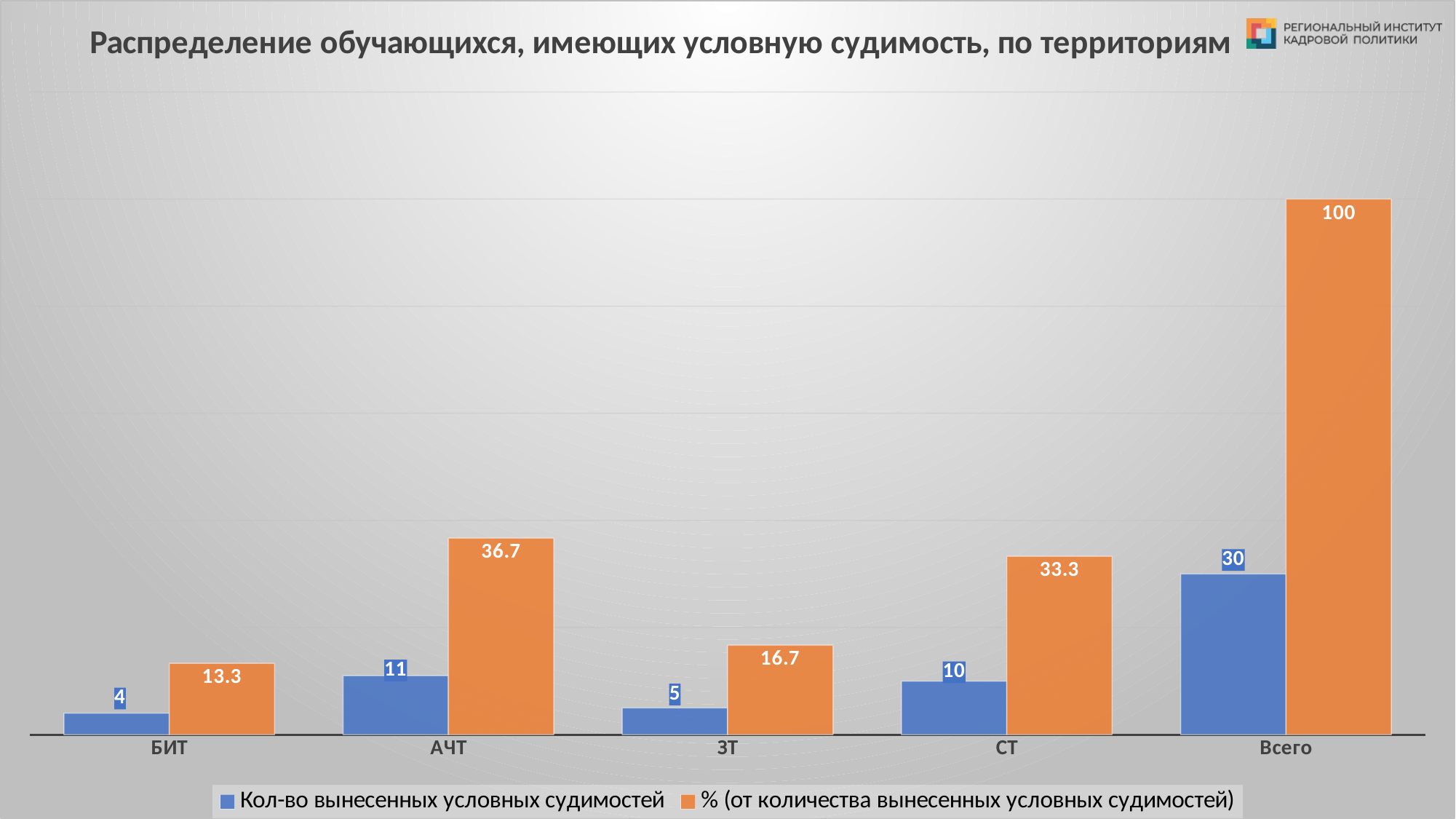
What is the difference between the 'Кол-во вынесенных условных судимостей' values for АЧТ and ЗТ? 6 How many categories are shown on the x axis? 5 What is the value of '% (от количества вынесенных условных судимостей)' for ЗТ? 16.7 How many series does the legend list? 2 Excluding Всего, which territory has the highest value of 'Кол-во вынесенных условных судимостей'? АЧТ What is the value of '% (от количества вынесенных условных судимостей)' for СТ? 33.3 What is the value of 'Кол-во вынесенных условных судимостей' for БИТ? 4 What is the value of 'Кол-во вынесенных условных судимостей' for АЧТ? 11 What type of chart is shown on the slide? Bar chart Which is larger: the '% (от количества вынесенных условных судимостей)' value for АЧТ or for СТ? АЧТ Which territory has the lowest value of '% (от количества вынесенных условных судимостей)'? БИТ What colour are the bars for the series 'Кол-во вынесенных условных судимостей'? Blue